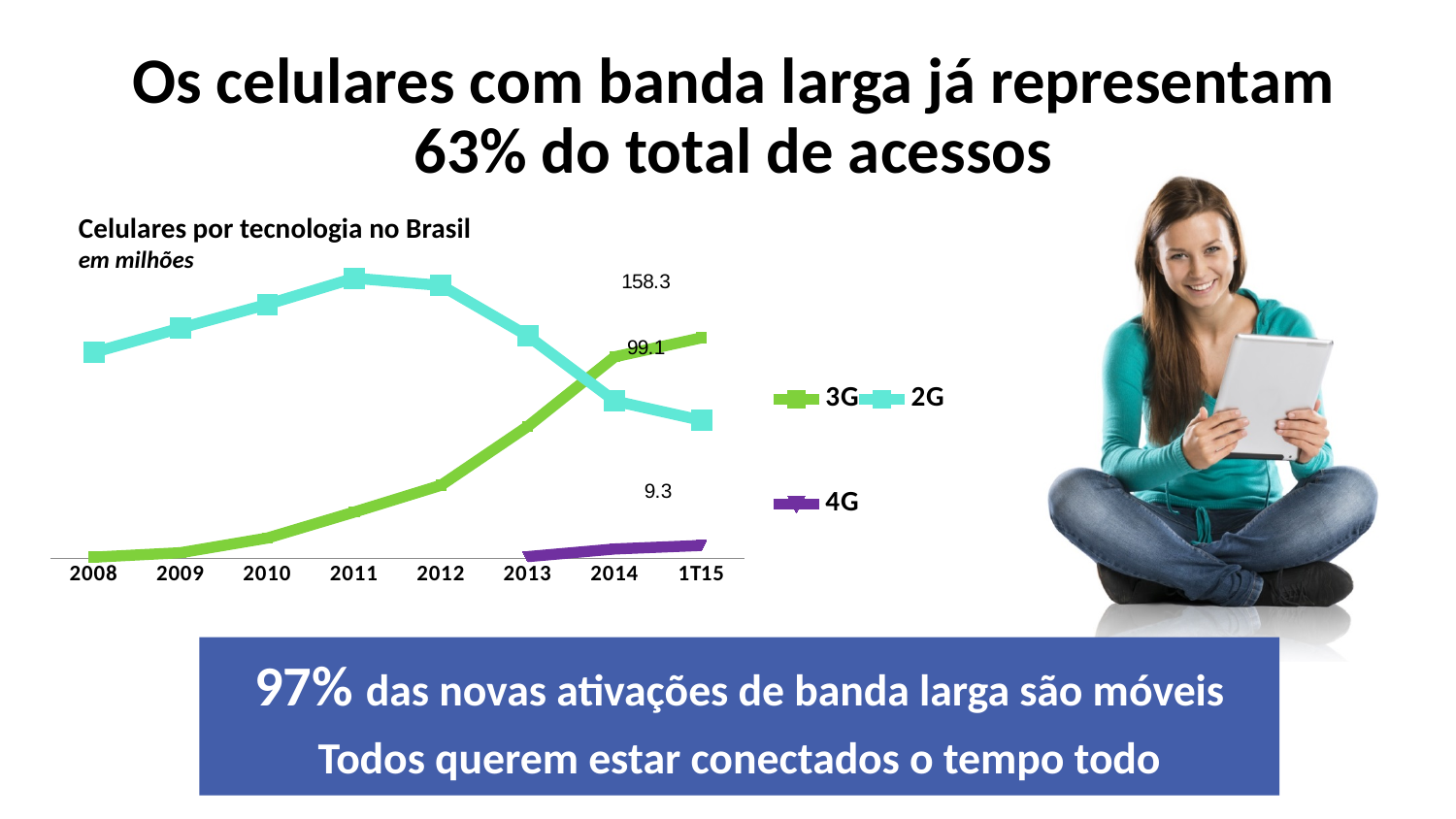
How many series does the chart legend list? 3 What is the labelled value for 4G at 1T15? 9.3 Which series are listed in the chart legend? 3G, 2G, 4G Which series has the highest value at 1T15? 3G How many time points are shown on the x axis of the chart? 8 What is the difference between the 3G and 2G values at 1T15? 59.2 In 2008, which is larger, the 2G value or the 3G value? 2G What is the labelled value for 3G at 1T15? 158.3 What kind of chart is shown on the slide? line chart Which series has the lowest value at 1T15? 4G What is the labelled value for 2G at 1T15? 99.1 What is the title of the chart? Celulares por tecnologia no Brasil